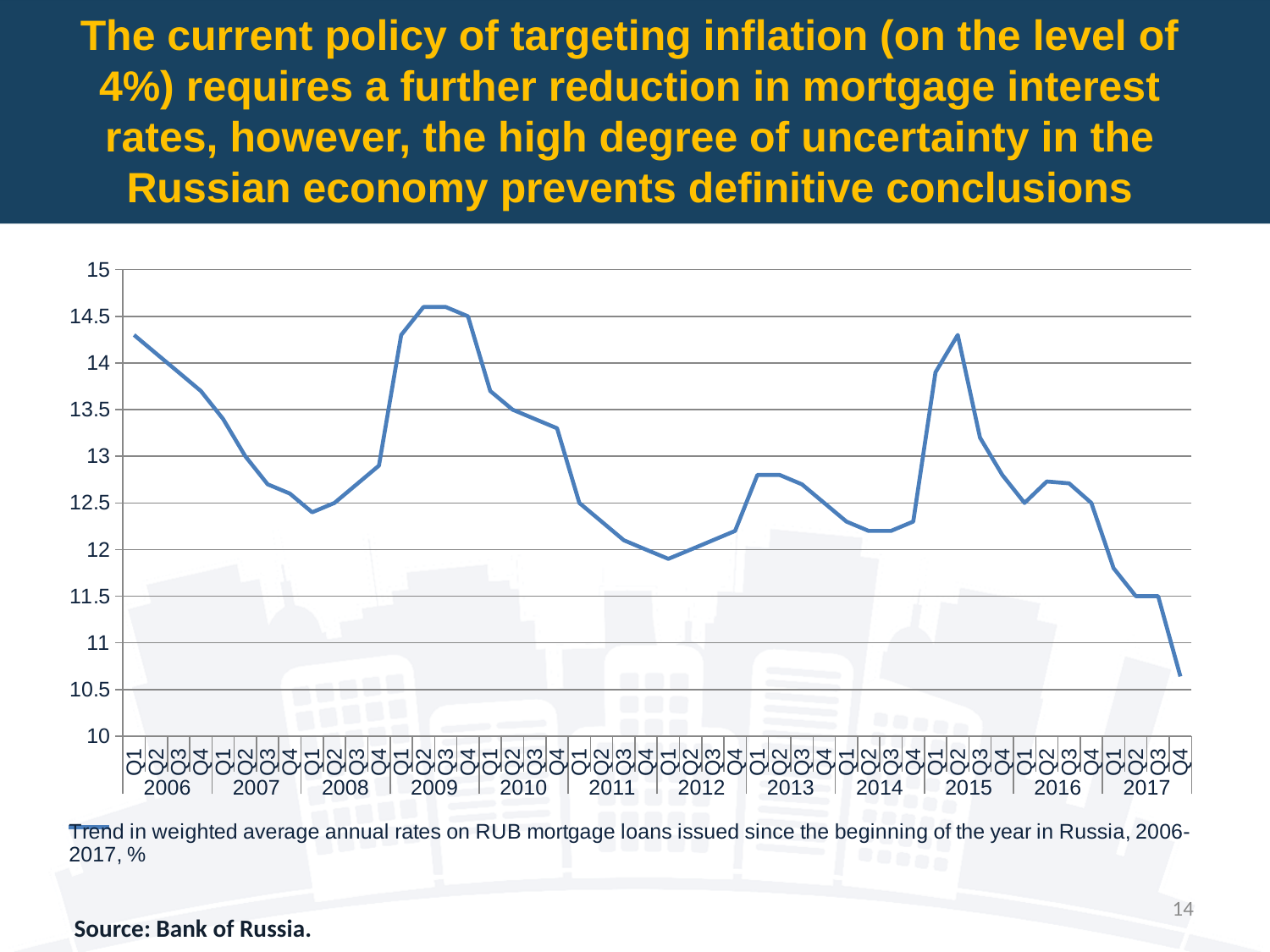
Is the value for Q1 2006 greater or less than 14? greater In which year does the line reach its highest point? 2009 How many quarterly data points are plotted on the chart? 48 Is the value for Q3 2017 greater or less than 12? less Which quarter has the lowest value on the chart? Q4 2017 How many years are covered on the x axis of the chart? 12 Is the value for Q2 2015 greater or less than 14? greater What source is cited for the chart data? Bank of Russia What kind of chart is shown on the slide? line chart Does the line rise or fall overall from Q1 2006 to Q4 2017? fall Which is larger, the value for Q2 2009 or the value for Q2 2012? Q2 2009